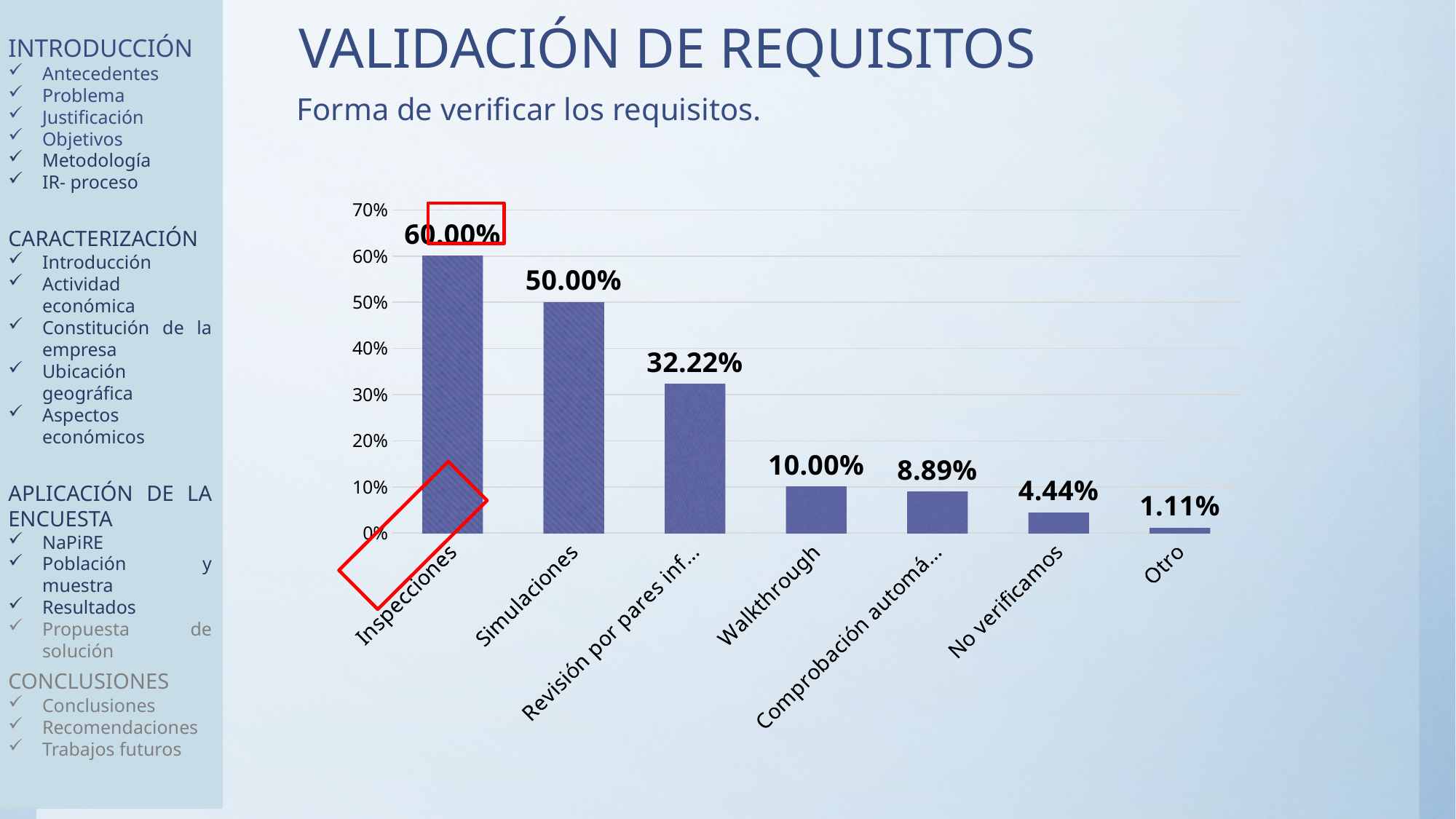
Do the values rise or fall from left to right along the x axis? Fall What is the value for Otro? 1.11% How many categories are shown in the chart? 7 What kind of chart is shown on the slide? Bar chart What is the value for No verificamos? 4.44% Which category has the highest value? Inspecciones What is the difference between the values for Inspecciones and Simulaciones? 10.00% What is the value for Simulaciones? 50.00% Which category has the lowest value? Otro Which is larger, the value for Walkthrough or the value for No verificamos? Walkthrough What is the value for Inspecciones? 60.00% What is the value for Walkthrough? 10.00%